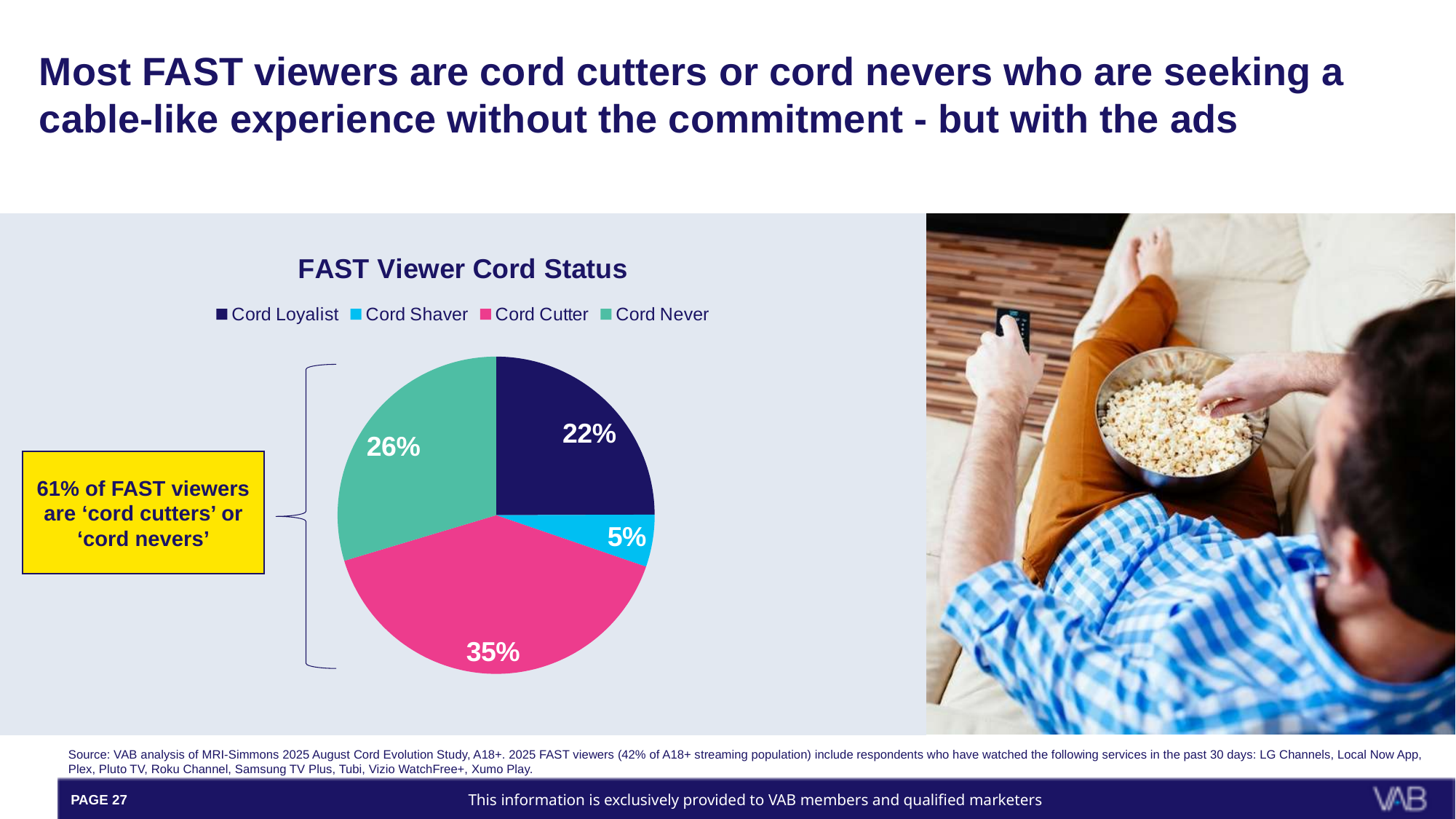
What share of FAST viewers are Cord Loyalists? 22% What share of FAST viewers are Cord Shavers? 5% How many categories does the legend list? 4 What share of FAST viewers are Cord Nevers? 26% What is the title of the chart? FAST Viewer Cord Status What is the combined share of Cord Cutters and Cord Nevers? 61% Which cord status category has the largest share of FAST viewers? Cord Cutter What share of FAST viewers are Cord Cutters? 35% Which cord status category has the smallest share of FAST viewers? Cord Shaver What type of chart is shown on the slide? pie chart What is the difference in percentage points between the Cord Cutter and Cord Loyalist shares? 13 Which is larger, the Cord Never share or the Cord Loyalist share? Cord Never